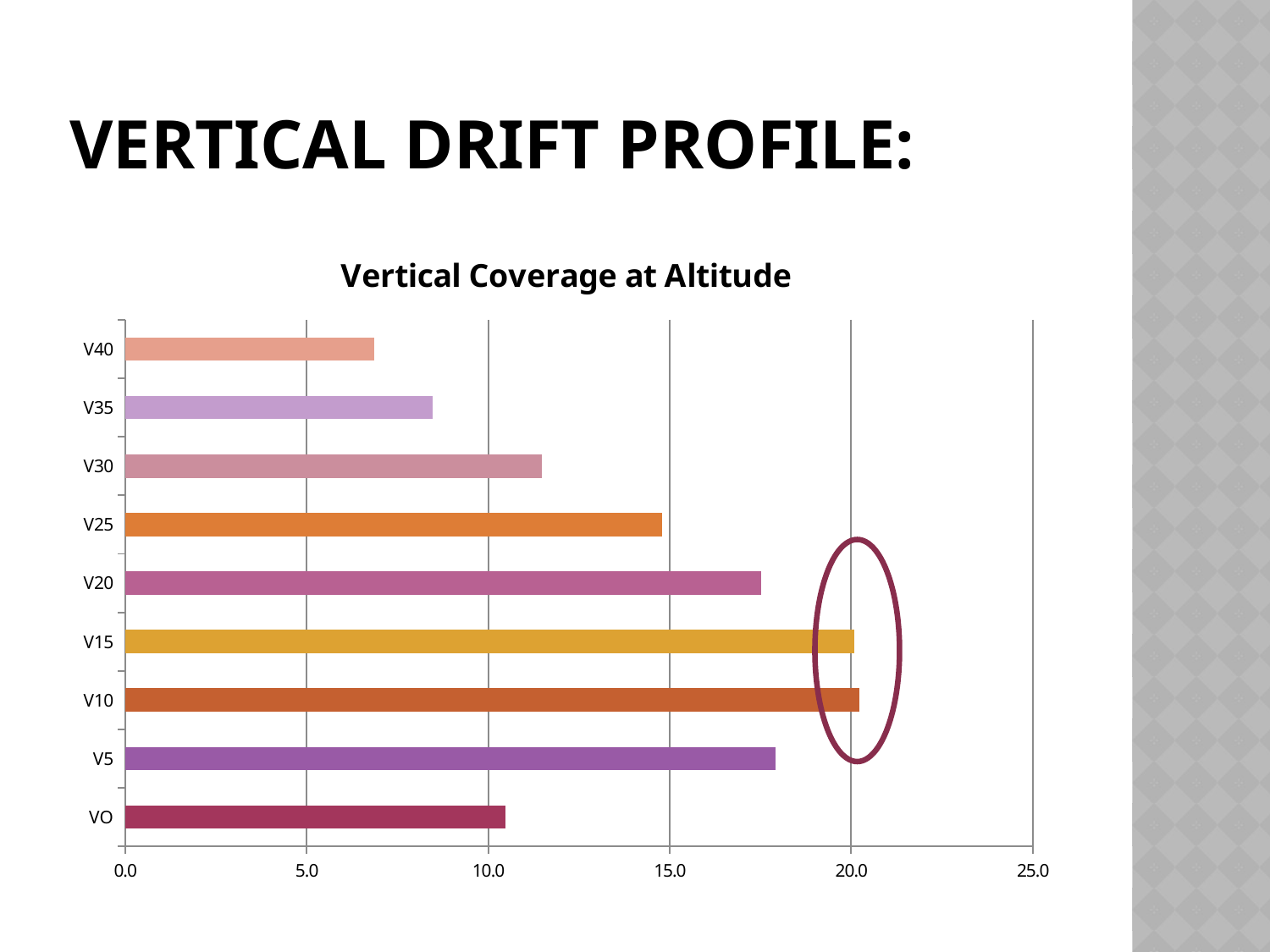
Which has the larger value, V25 or V35? V25 Is the value for V5 greater or less than 15.0? greater Which has the larger value, V20 or V30? V20 What kind of chart is shown on the slide? bar chart Which category has the lowest value? V40 Is the value for V30 greater or less than 10.0? greater How many categories are plotted in the chart? 9 What is the title of the chart? Vertical Coverage at Altitude Is the value for V20 greater or less than 15.0? greater Going from V15 up to V40, do the values rise or fall? fall